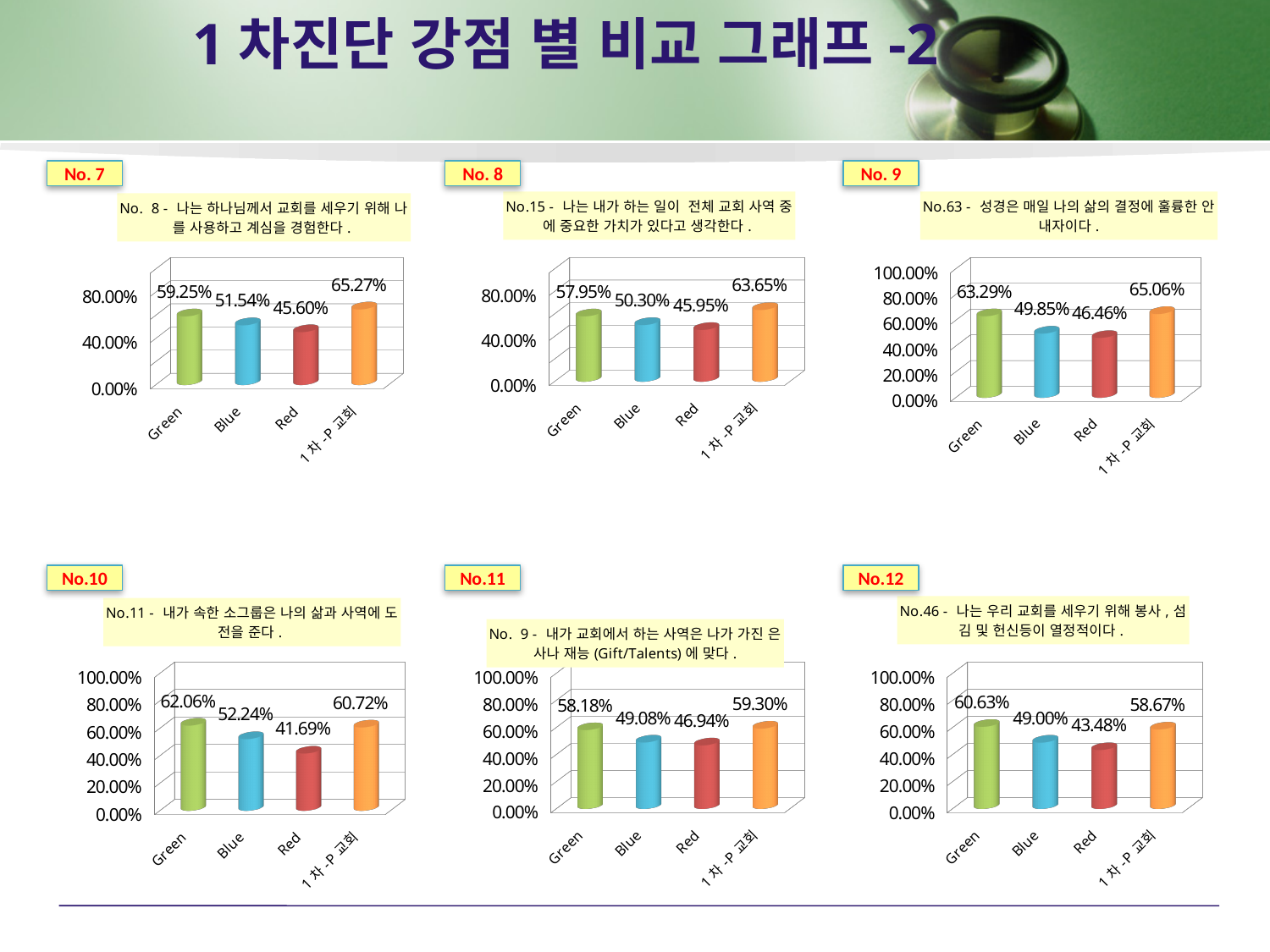
In the bottom-left chart (No.10), what is the value for Red? 41.69% In the top-middle chart (No. 8), what is the value for Red? 45.95% In the top-right chart (No. 9), what is the difference between the values for 1차-P 교회 and Green? 1.77% How many categories are shown on the x axis of the bottom-right chart (No.12)? 4 In the bottom-left chart (No.10), which is larger, the value for Green or the value for 1차-P 교회? Green What kind of chart is the top-left chart (No. 7)? Bar chart In the top-middle chart (No. 8), which category has the lowest value? Red In the top-left chart (No. 7), what is the value for Green? 59.25% In the bottom-right chart (No.12), what is the difference between the values for Green and Blue? 11.63% In the bottom-middle chart (No.11), what is the value for 1차-P 교회? 59.30% In the top-right chart (No. 9), what is the value for Blue? 49.85% In the top-left chart (No. 7), which category has the highest value? 1차-P 교회